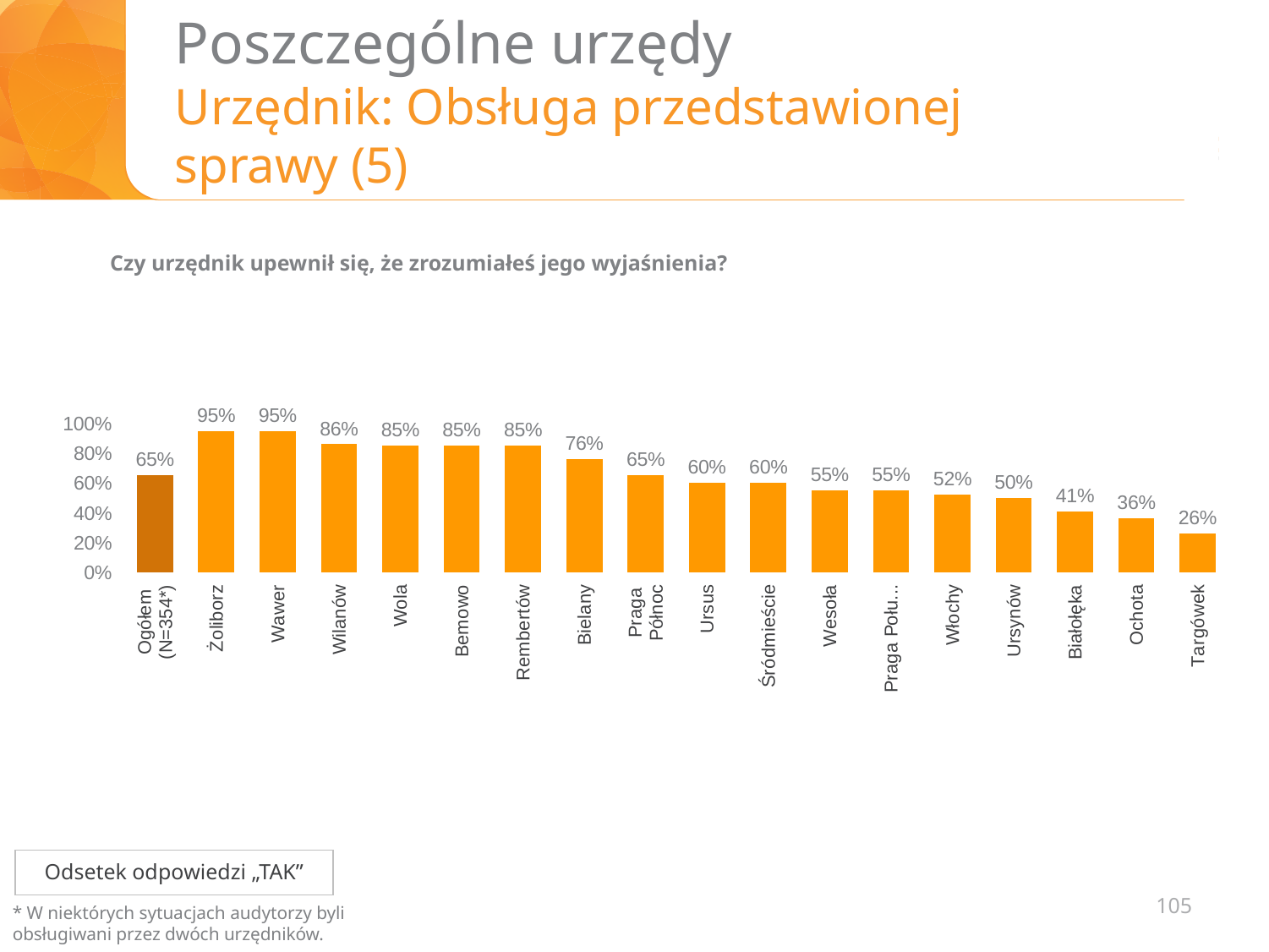
Do the values generally rise or fall from Żoliborz to Targówek along the x axis? fall How many bars are shown in the chart? 18 Which is larger, the value for Ursus or the value for Białołęka? Ursus What is the value for Bielany? 76% What is the value for Ogółem (N=354*)? 65% Is the value for Włochy greater or less than 40%? greater Which category has the lowest value? Targówek What is the difference between the values for Wola and Ursynów? 35% What kind of chart is shown on the slide? bar chart What is the value for Wilanów? 86% What is the value for Ochota? 36% What is the difference between the values for Żoliborz and Targówek? 69%